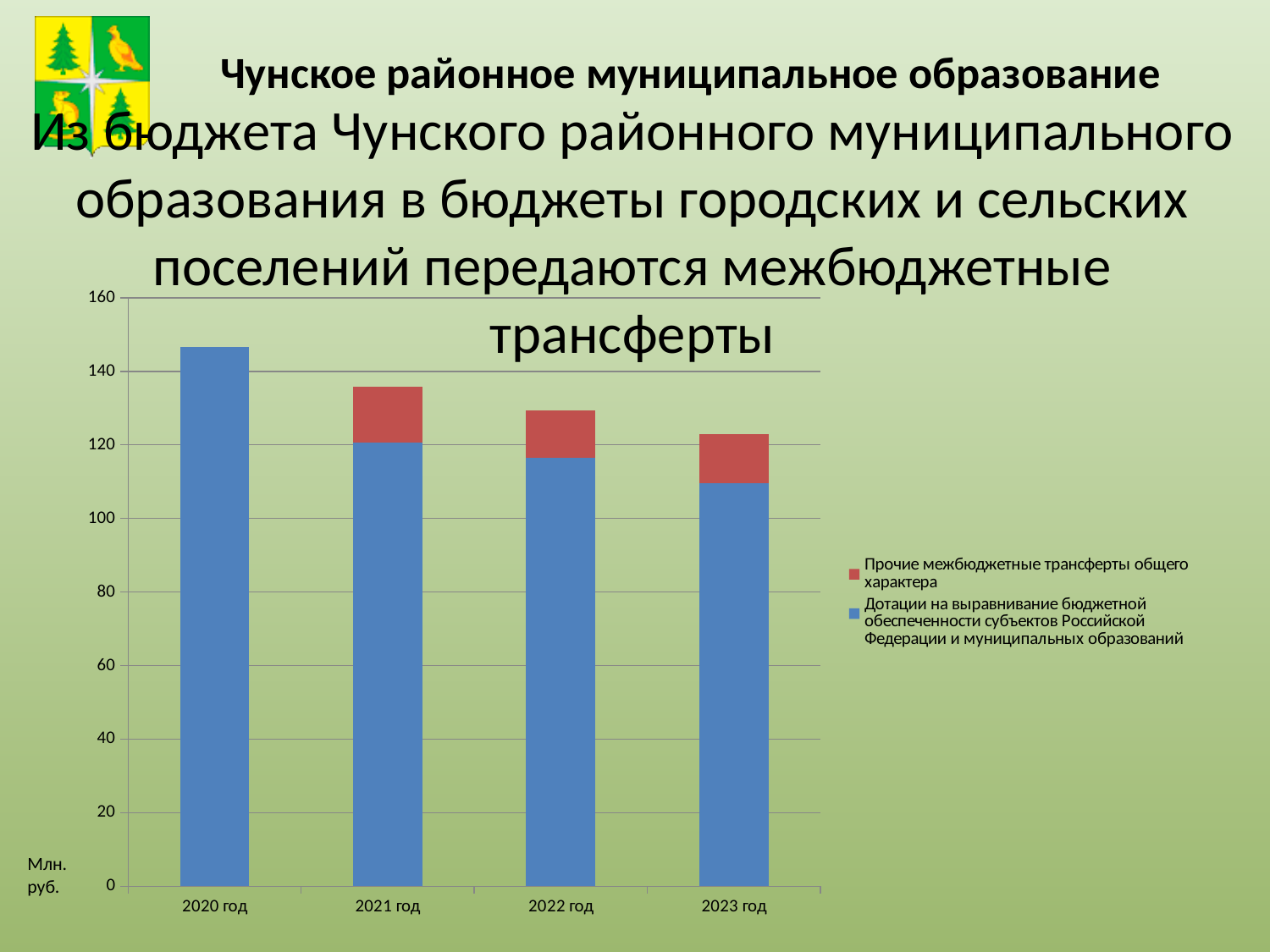
Which year has the tallest bar in the chart? 2020 год Do the total bar heights rise or fall from 2020 год to 2023 год? Fall Which year has the shortest bar in the chart? 2023 год Which year has the larger value for 'Дотации на выравнивание бюджетной обеспеченности...': 2020 год or 2023 год? 2020 год Is the total bar height for 2020 год greater or less than 140? greater How many years (categories) are shown on the x axis of the chart? 4 Is the total bar height for 2021 год greater or less than 140? less How many series does the chart's legend list? 2 What colour represents 'Прочие межбюджетные трансферты общего характера' in the chart? Red What kind of chart is shown on the slide? Stacked bar chart Is the value of 'Дотации на выравнивание бюджетной обеспеченности...' for 2023 год greater or less than 100? greater